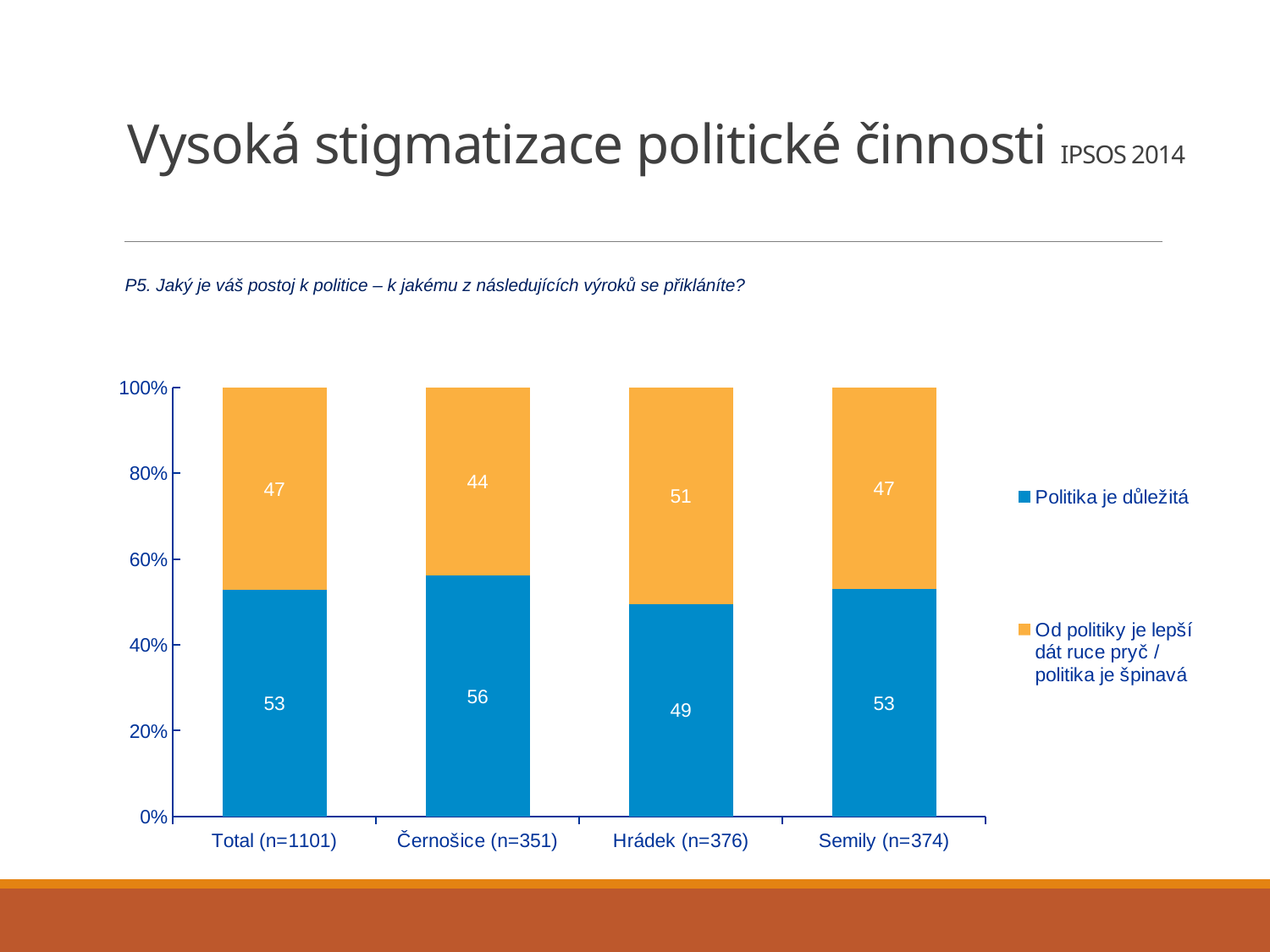
Which is larger: the "Od politiky je lepší dát ruce pryč / politika je špinavá" value for Hrádek (n=376) or for Černošice (n=351)? Hrádek (n=376) What kind of chart is shown on the slide? Stacked bar chart Which colour represents "Politika je důležitá" in the chart? Blue Which category has the highest value for "Politika je důležitá"? Černošice (n=351) What is the total of the stacked bar for Semily (n=374)? 100 How many categories are shown on the x axis? 4 What is the value for "Politika je důležitá" in Total (n=1101)? 53 What is the value for "Od politiky je lepší dát ruce pryč / politika je špinavá" in Hrádek (n=376)? 51 How many series does the legend list? 2 What is the difference between the "Politika je důležitá" values for Černošice (n=351) and Hrádek (n=376)? 7 What is the value for "Politika je důležitá" in Černošice (n=351)? 56 Which category has the lowest value for "Politika je důležitá"? Hrádek (n=376)